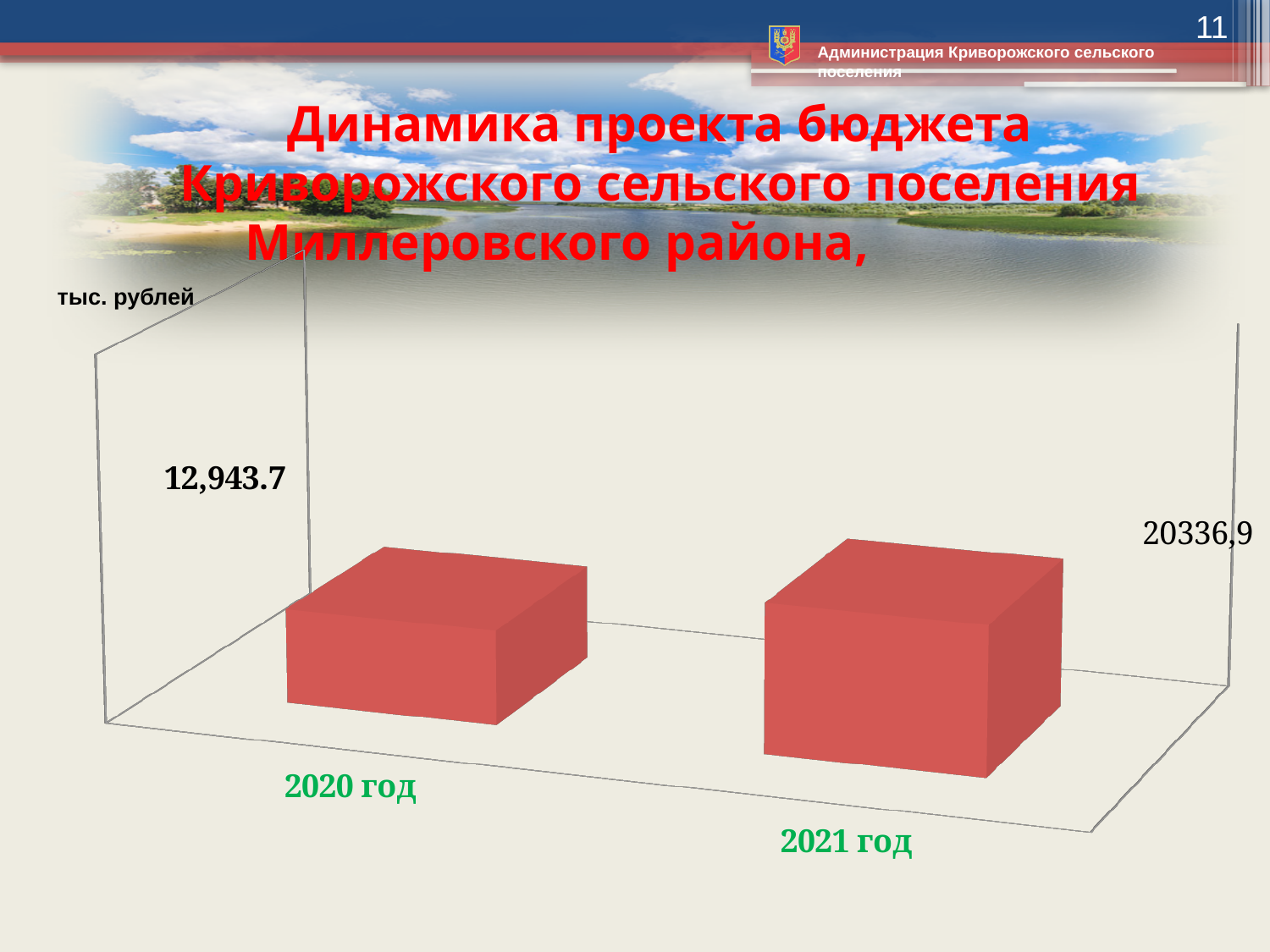
What kind of chart is shown on the slide? bar chart Which year has the higher value? 2021 год In what units are the chart values given? тыс. рублей What colour are the bars in the chart? red Do the values rise or fall from 2020 год to 2021 год? rise Is the value for 2021 год larger or smaller than the value for 2020 год? larger What is the difference between the values for 2021 год and 2020 год? 7393.2 How many categories (years) are shown in the chart? 2 What is the value for 2021 год? 20336,9 What is the value for 2020 год? 12,943.7 Which year has the lower value? 2020 год